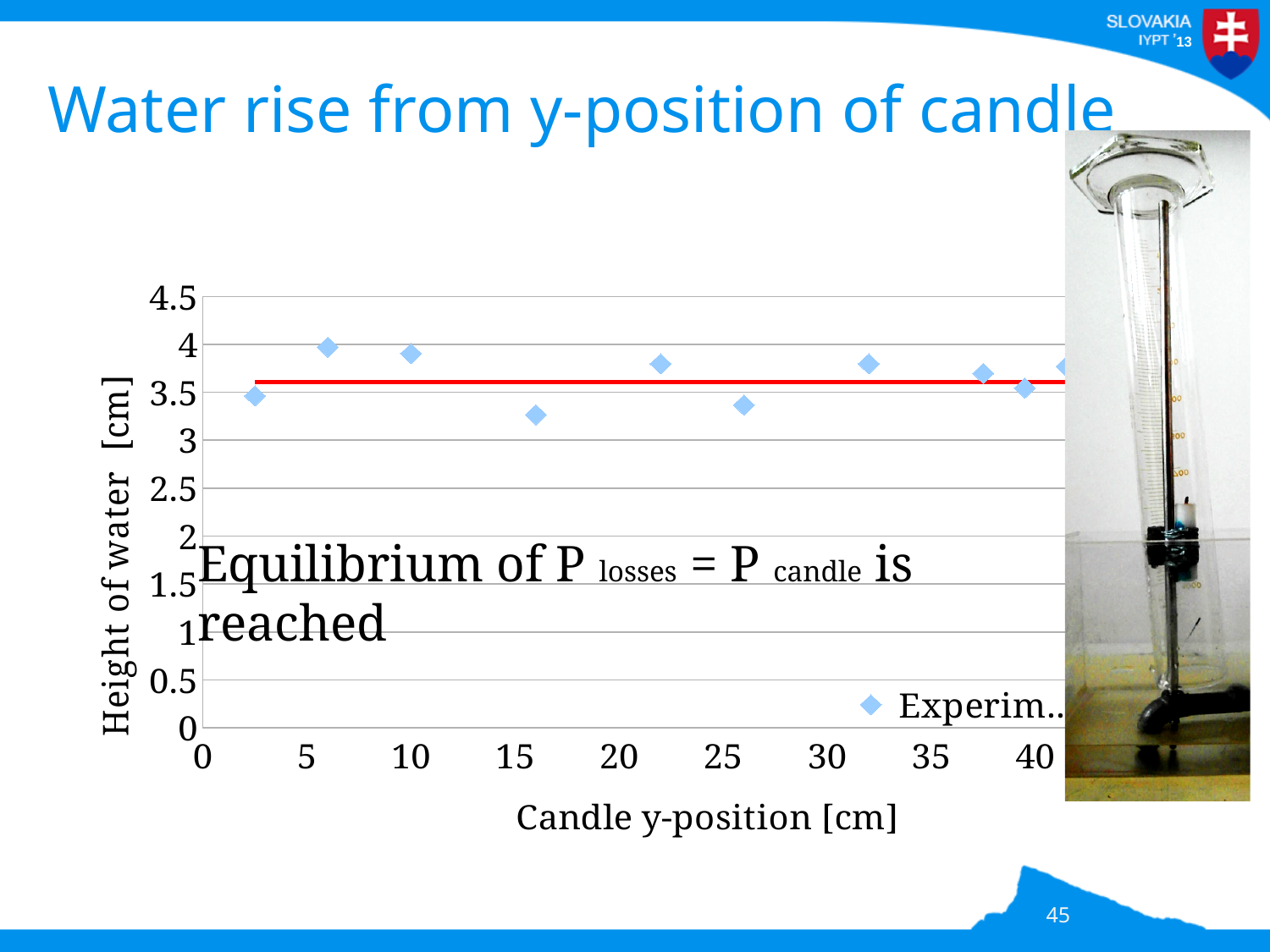
Is the height of water for the point at a candle y-position of about 22 cm greater or less than 3.5? greater What is the highest tick value shown on the y axis of the chart? 4.5 Is the height of water for the point at a candle y-position of about 16 cm greater or less than 3.5? less What kind of chart is shown on the slide? scatter chart Do the plotted heights of water clearly rise or fall as the candle y-position increases? neither, they stay roughly constant Are all the plotted points above a height of water of 3 cm? yes What is the label of the x axis of the chart? Candle y-position [cm] What is the title of the chart on the slide? Water rise from y-position of candle Which point has the larger height of water: the one at a candle y-position of about 6 cm or the one at about 16 cm? the one at about 6 cm